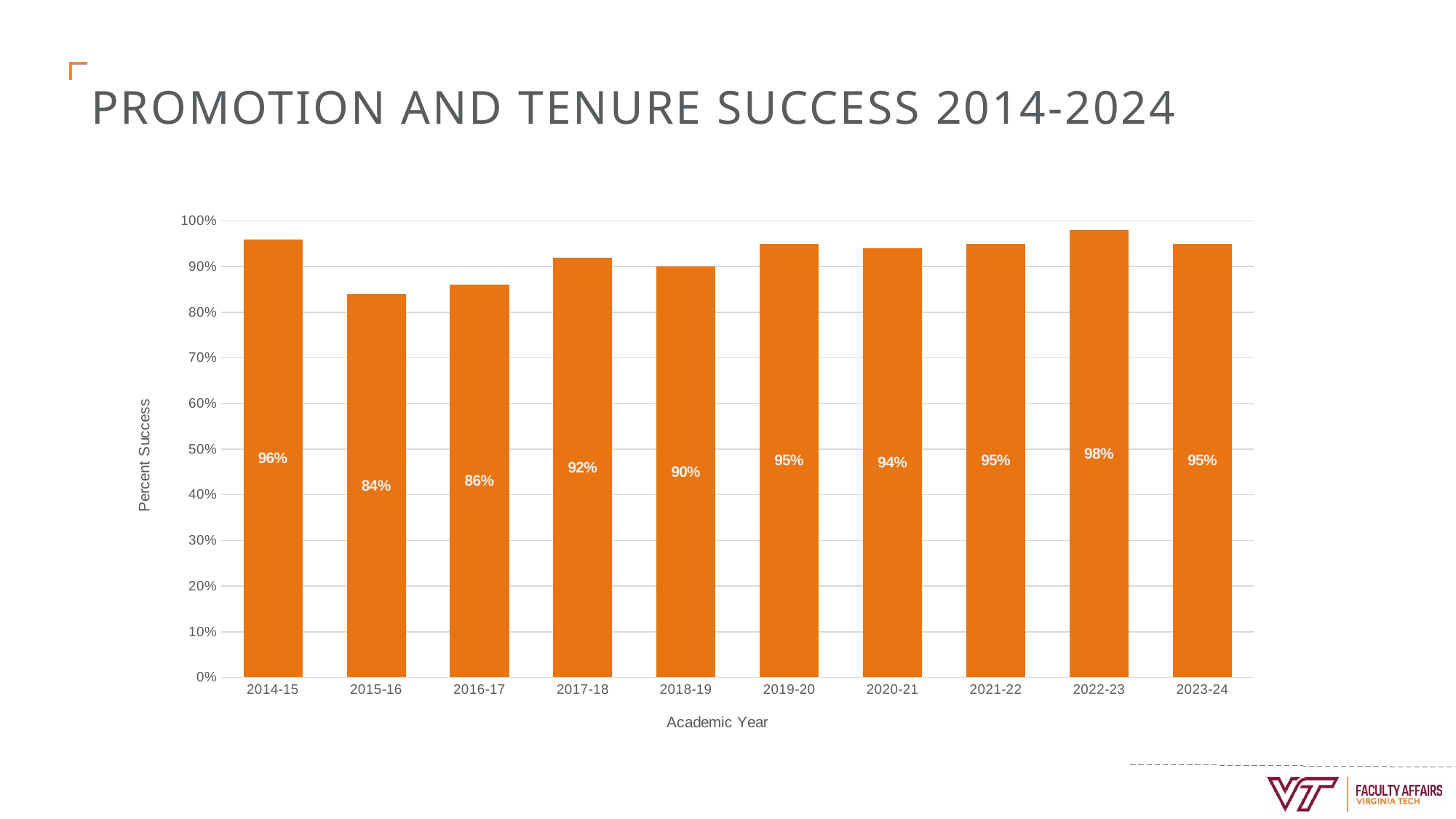
Which academic year has the lowest percent success? 2015-16 Is the value for 2016-17 greater or less than 90%? less What is the label of the y axis? Percent Success What kind of chart is shown on the slide? Bar chart Which has a higher percent success, 2014-15 or 2020-21? 2014-15 What is the difference in percent success between 2022-23 and 2015-16? 14% What is the percent success for 2018-19? 90% What is the percent success for 2022-23? 98% What is the percent success for 2014-15? 96% What is the difference in percent success between 2017-18 and 2016-17? 6% Which academic year has the highest percent success? 2022-23 How many academic years are shown on the chart? 10